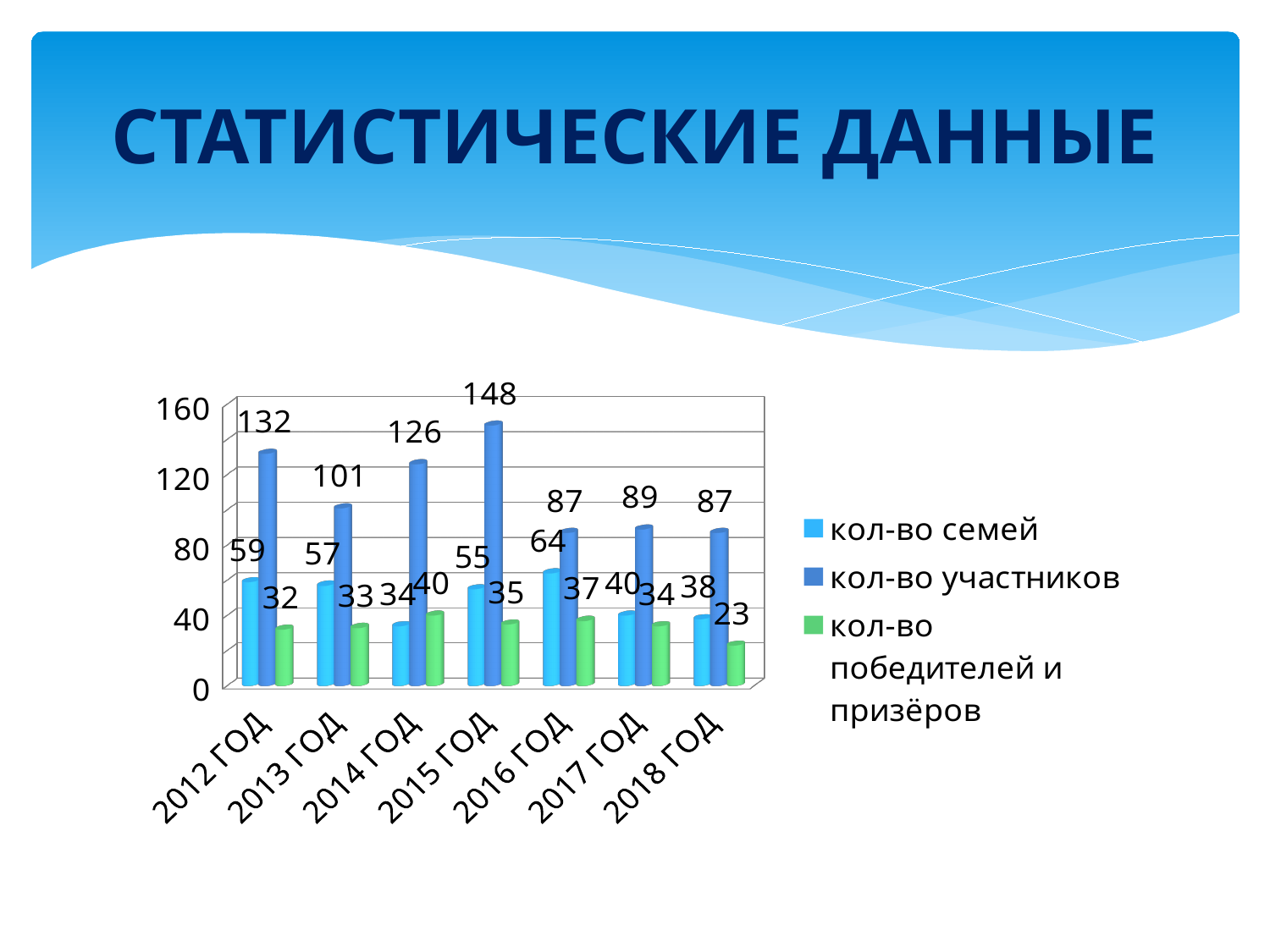
In which year is кол-во победителей и призёров lowest? 2018 год Does кол-во участников rise or fall from 2015 год to 2016 год? fall What is the value for кол-во победителей и призёров in 2018 год? 23 How many years are shown on the x axis? 7 What is the value for кол-во участников in 2015 год? 148 What is the difference between кол-во участников in 2012 год and 2013 год? 31 Which is larger: кол-во семей in 2014 год or кол-во победителей и призёров in 2014 год? кол-во победителей и призёров How many series does the legend list? 3 In which year is кол-во участников highest? 2015 год What is the value for кол-во семей in 2016 год? 64 What colour are the bars for кол-во победителей и призёров? green What kind of chart is shown on the slide? bar chart